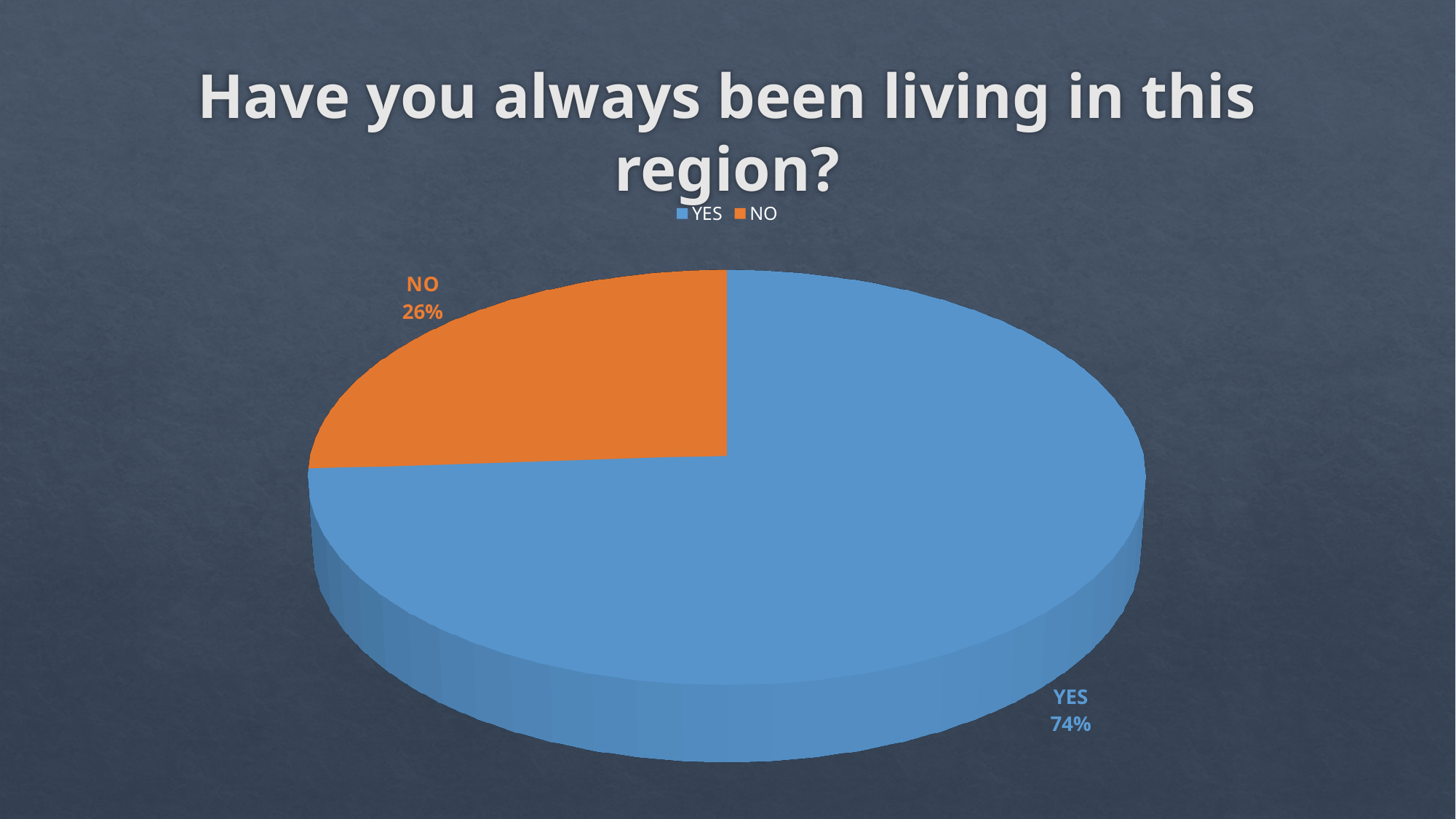
Which slice is the smallest in the pie chart? NO How many slices does the pie chart have? 2 What share of the pie does the YES slice represent? 74% Which slice is larger, YES or NO? YES What kind of chart is shown on the slide? Pie chart What share of the pie does the NO slice represent? 26% What is the title of the chart? Have you always been living in this region? How many entries does the legend list? 2 What is the difference in percentage points between the YES and NO slices? 48 What colour is the NO slice? Orange Which slice is the largest in the pie chart? YES